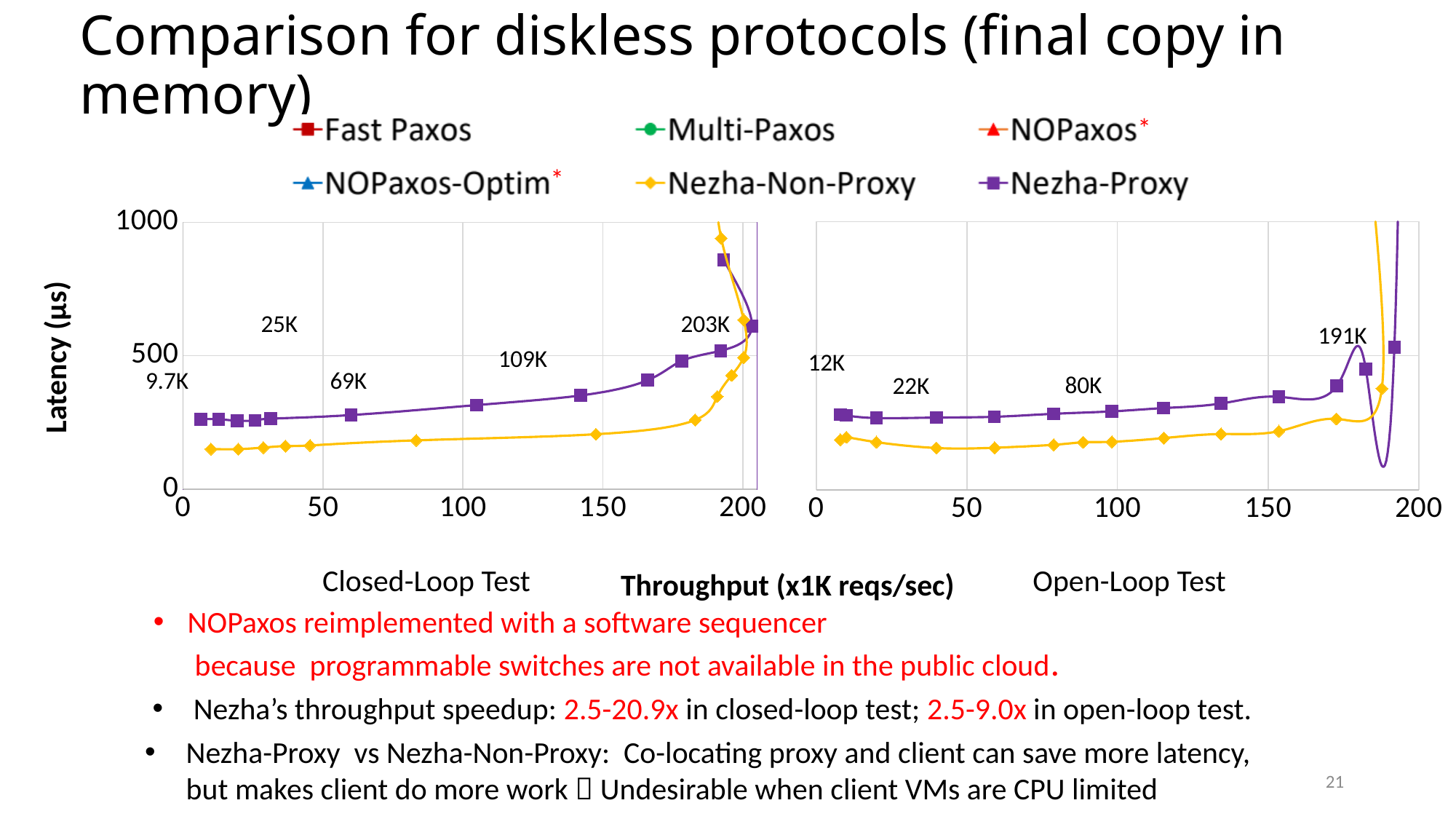
How many series does the legend list? 6 In the Closed-Loop Test chart, what throughput annotation is printed at the far left near the start of the Nezha-Proxy curve? 9.7K In the Open-Loop Test chart, is the latency of Nezha-Non-Proxy at a throughput of 100 greater or less than 500? less In the Closed-Loop Test chart, at a throughput of 100, which series has the higher latency, Nezha-Proxy or Nezha-Non-Proxy? Nezha-Proxy What kind of chart is the Closed-Loop Test chart? line chart In the Open-Loop Test chart, what throughput annotation is printed near the right end of the Nezha-Proxy curve? 191K What is the label on the y axis of the charts? Latency (μs) In the Closed-Loop Test chart, is the latency of Nezha-Proxy at a throughput of 50 greater or less than 500? less In the Open-Loop Test chart, what throughput annotation is printed at the far left near the start of the curves? 12K What is the shared x-axis label printed below the two charts? Throughput (x1K reqs/sec) In the Closed-Loop Test chart, what throughput annotation is printed near the right end of the Nezha-Proxy curve? 203K In the Closed-Loop Test chart, does the latency of Nezha-Proxy rise or fall as throughput increases from 0 to 200? rise